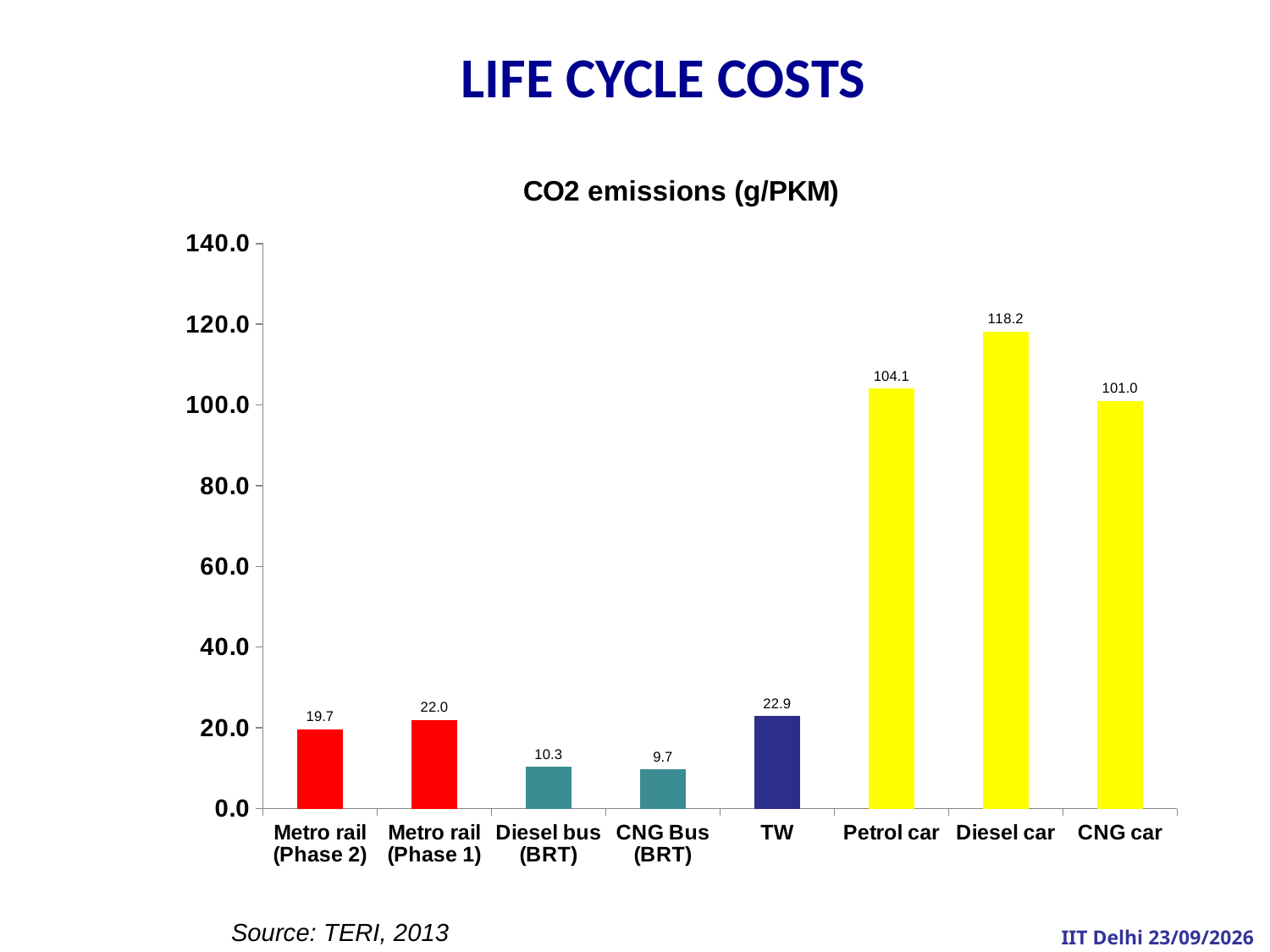
What is the difference in CO2 emissions between Metro rail (Phase 1) and Metro rail (Phase 2)? 2.3 What is the CO2 emissions value for CNG Bus (BRT)? 9.7 What is the difference in CO2 emissions between Petrol car and CNG car? 3.1 What is the CO2 emissions value for Diesel car? 118.2 Is the value for Petrol car greater or less than 100.0? greater What kind of chart is shown on the slide? Bar chart How many categories are shown on the x axis? 8 What is the CO2 emissions value for TW? 22.9 Which category has the highest CO2 emissions? Diesel car What is the title of the chart? CO2 emissions (g/PKM) Which category has the lowest CO2 emissions? CNG Bus (BRT) Which has higher CO2 emissions, Diesel bus (BRT) or TW? TW